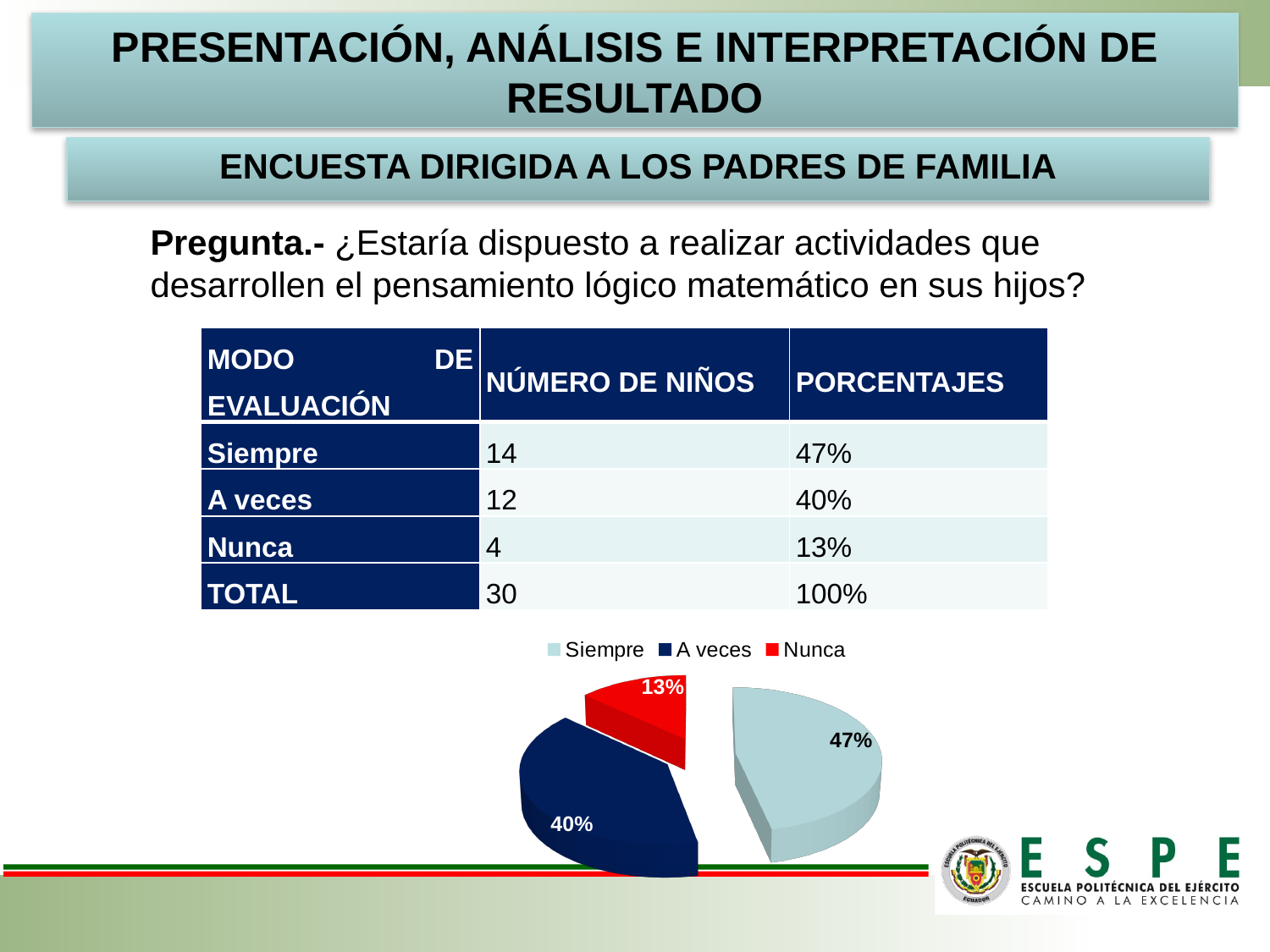
What is the difference in percentage points between the Siempre and A veces slices? 7 What percentage does the Nunca slice show in the pie chart? 13% Which slice is larger, A veces or Nunca? A veces Which category has the smallest slice in the pie chart? Nunca How many entries does the legend of the pie chart list? 3 What colour is the Nunca slice in the pie chart? red What is the difference in percentage points between the Siempre and Nunca slices? 34 What kind of chart is shown on the slide? pie chart What percentage does the A veces slice show in the pie chart? 40% What percentage does the Siempre slice show in the pie chart? 47% How many slices does the pie chart have? 3 Which category has the largest slice in the pie chart? Siempre